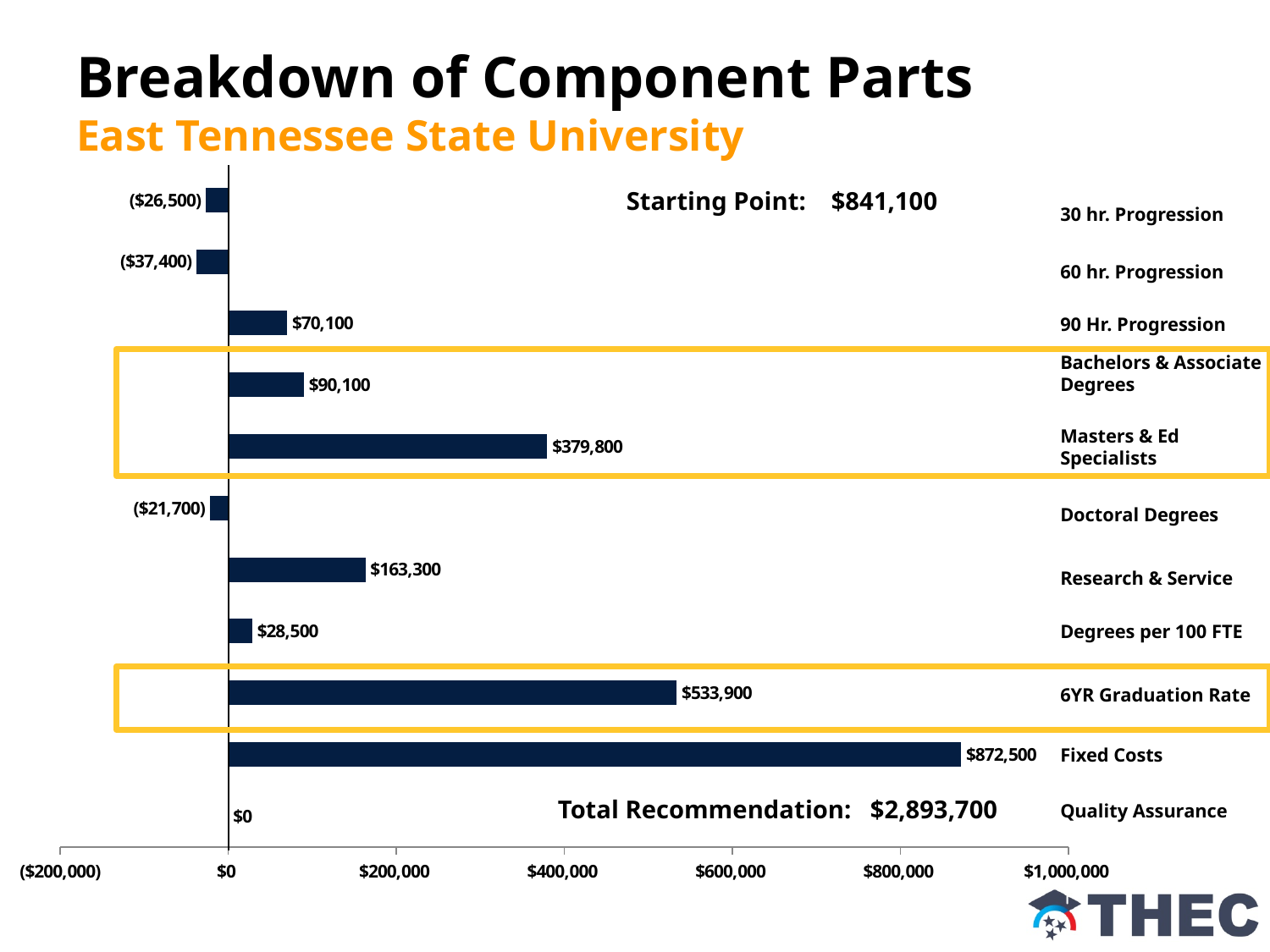
How many categories are shown in the chart? 11 What is the difference between the values for Fixed Costs and 6YR Graduation Rate? $338,600 What is the value for 60 hr. Progression? ($37,400) Which category has the highest value? Fixed Costs What Starting Point amount is printed on the chart? $841,100 What kind of chart is shown on the slide? bar chart Which category has the lowest value? 60 hr. Progression What is the value for Fixed Costs? $872,500 Which is larger, the value for Research & Service or the value for Bachelors & Associate Degrees? Research & Service What is the value for Masters & Ed Specialists? $379,800 What is the value for Quality Assurance? $0 Is the value for 6YR Graduation Rate greater or less than $400,000? greater